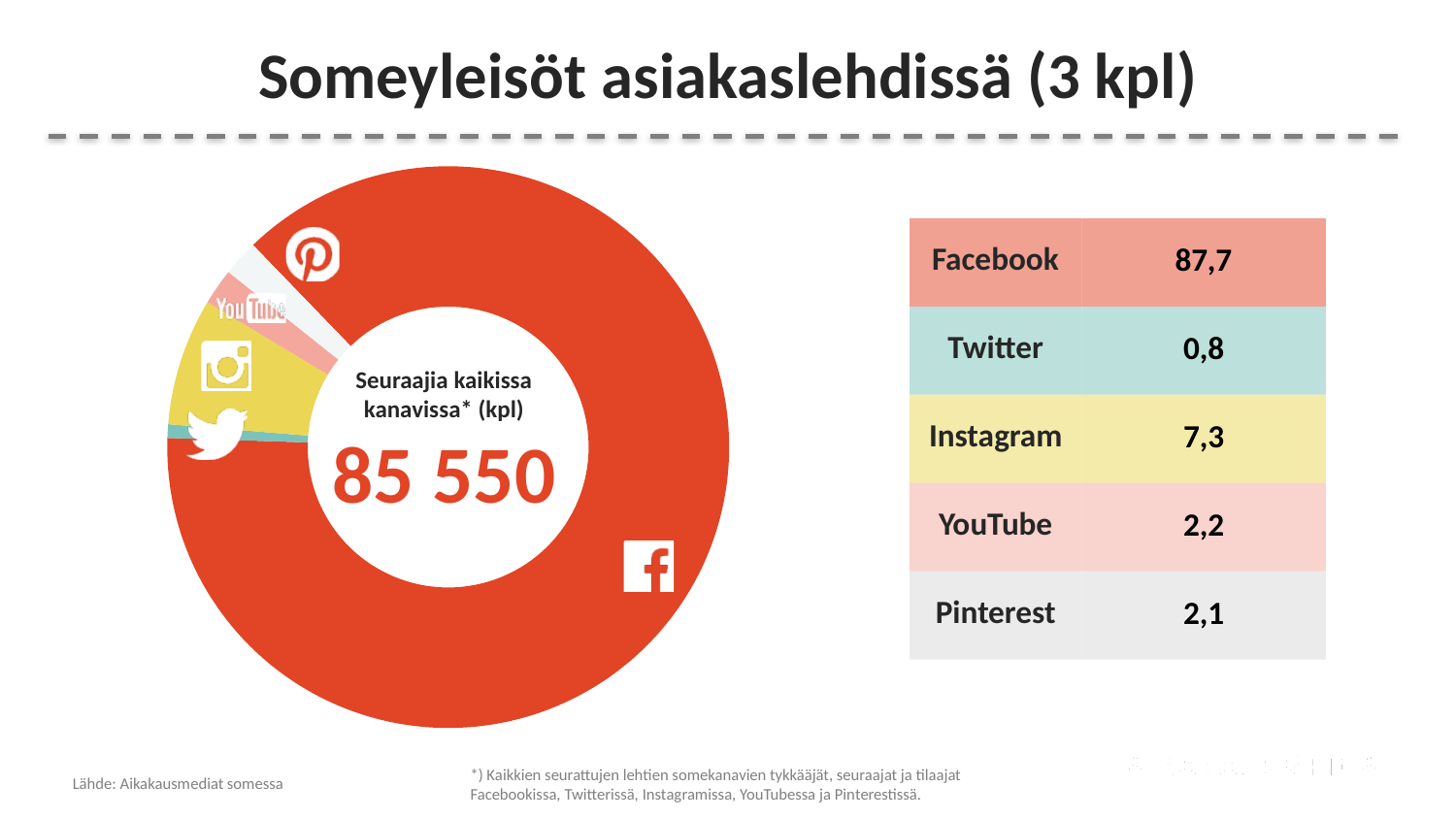
What is the value shown for Pinterest? 2,1 What total number of followers across all channels is shown in the centre of the donut chart? 85 550 What is the difference between the values for Facebook and Instagram? 80,4 Which has a larger value, YouTube or Pinterest? YouTube What is the value shown for Twitter? 0,8 Which channel has the smallest value? Twitter What is the value shown for Instagram? 7,3 What kind of chart is shown on the slide? Donut (pie) chart What is the title of the slide? Someyleisöt asiakaslehdissä (3 kpl) How many channels (categories) are shown in the chart? 5 What is the value shown for Facebook? 87,7 Which channel has the largest share of the donut chart? Facebook